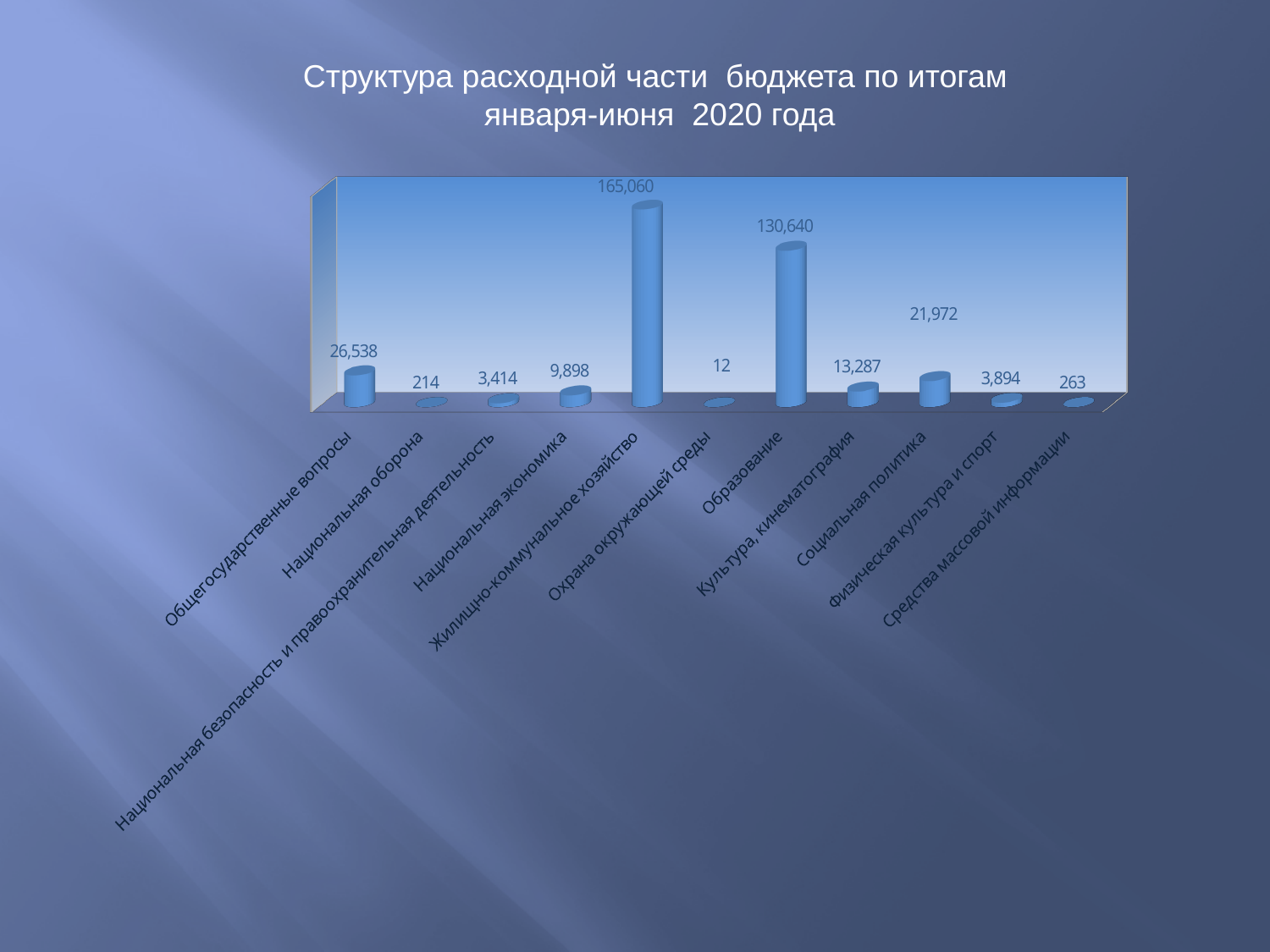
What value is shown for Охрана окружающей среды? 12 What value is shown for Социальная политика? 21,972 Which category has the lowest value? Охрана окружающей среды What is the title of the slide? Структура расходной части бюджета по итогам января-июня 2020 года How many categories are shown in the chart? 11 What is the difference between the values for Жилищно-коммунальное хозяйство and Образование? 34,420 What value is shown for Национальная оборона? 214 What value is shown for Жилищно-коммунальное хозяйство? 165,060 What kind of chart is shown on the slide? Bar chart What value is shown for Образование? 130,640 Which category has the highest value? Жилищно-коммунальное хозяйство Which is larger: the value for Общегосударственные вопросы or the value for Социальная политика? Общегосударственные вопросы